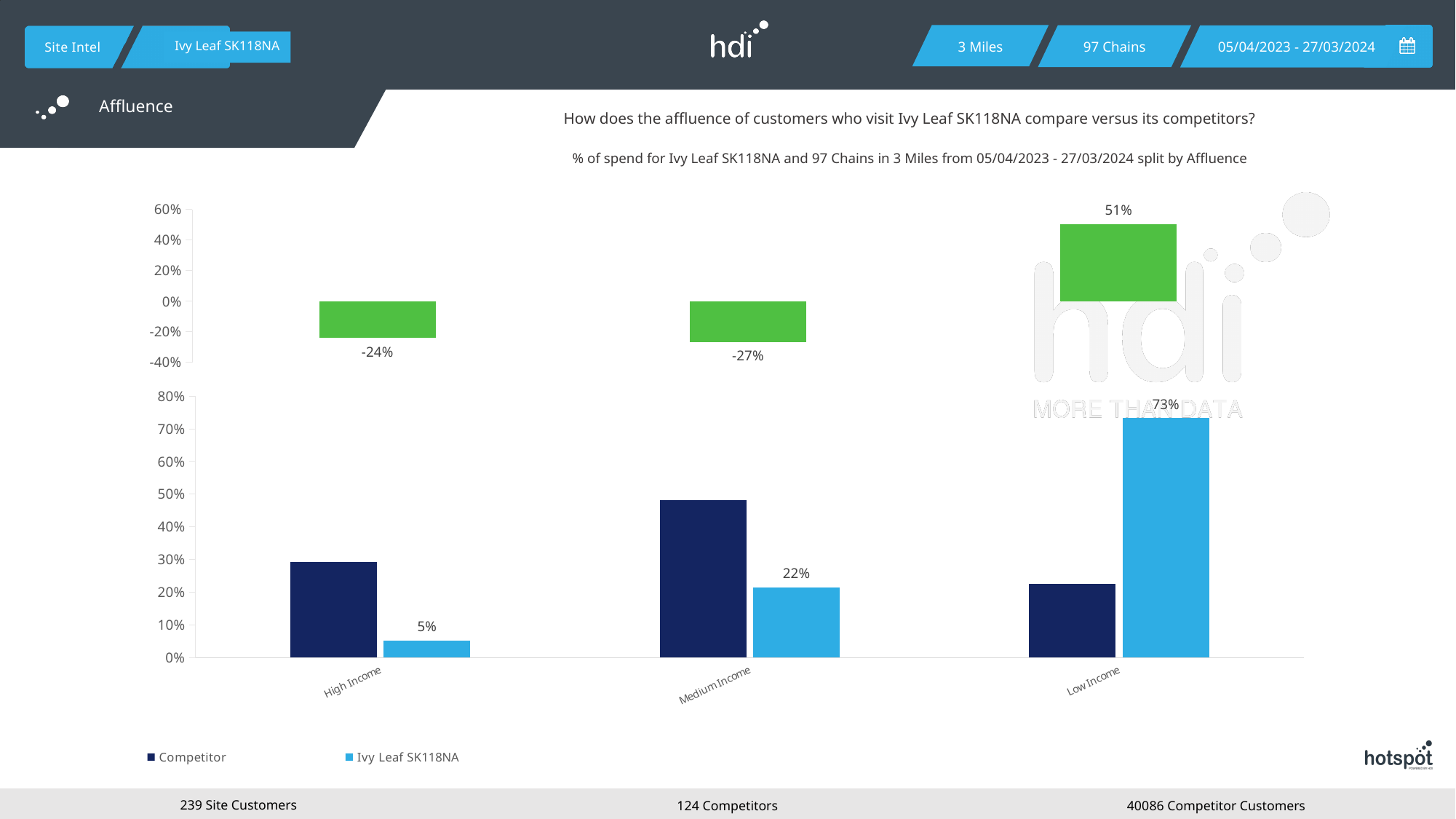
In the top chart, which category has the lowest value? Medium Income In the bottom chart, what is the value for Ivy Leaf SK118NA in the High Income category? 5% In the bottom chart, is the Competitor value for Low Income greater or less than 30%? less What type of chart is the bottom chart? Bar chart In the bottom chart, what is the value for Ivy Leaf SK118NA in the Medium Income category? 22% In the top chart, what is the value shown for the Medium Income category? -27% In the bottom chart, is the Competitor value for Medium Income greater or less than 40%? greater In the bottom chart, what is the value for Ivy Leaf SK118NA in the Low Income category? 73% In the bottom chart, what is the difference between the Ivy Leaf SK118NA values for Low Income and High Income? 68% In the bottom chart, which is larger for Medium Income: Competitor or Ivy Leaf SK118NA? Competitor How many series does the legend of the bottom chart list? 2